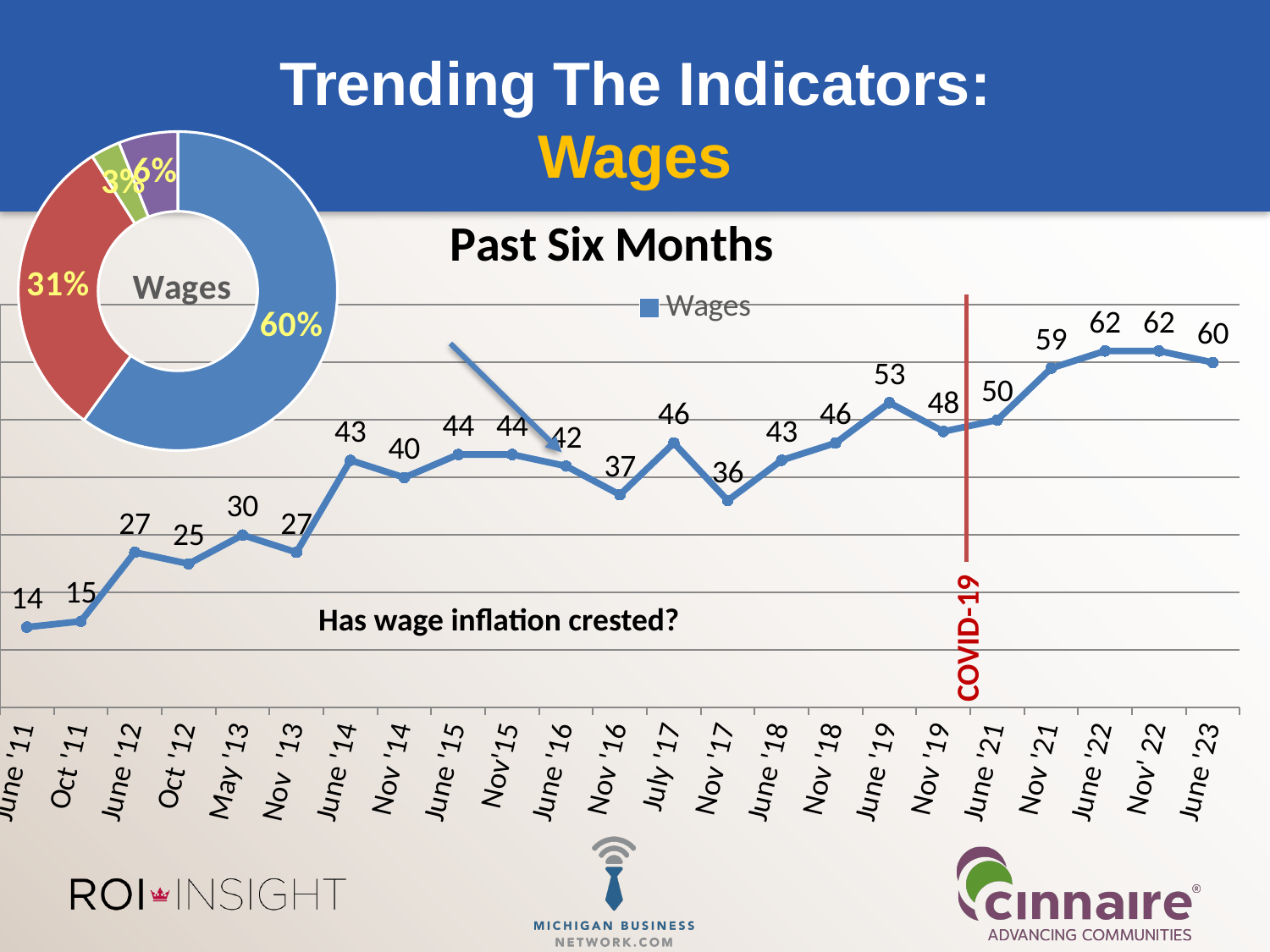
In the line chart titled 'Past Six Months', how many series does the legend list? 1 In the line chart titled 'Past Six Months', which date has the lowest value? June '11 In the line chart titled 'Past Six Months', what is the highest value plotted? 62 In the line chart titled 'Past Six Months', how many data points are plotted? 23 In the donut chart labelled 'Wages' at the top left, what share does the red slice have? 31% In the line chart titled 'Past Six Months', which is larger, the value for July '17 or the value for Nov '17? July '17 In the line chart titled 'Past Six Months', what is the value for June '11? 14 In the line chart titled 'Past Six Months', what is the value for June '19? 53 In the line chart titled 'Past Six Months', what is the value for June '23? 60 In the line chart titled 'Past Six Months', what is the difference between the values for Nov '21 and June '21? 9 What kind of chart is the chart titled 'Past Six Months'? Line chart In the donut chart labelled 'Wages' at the top left, what share does the largest slice have? 60%